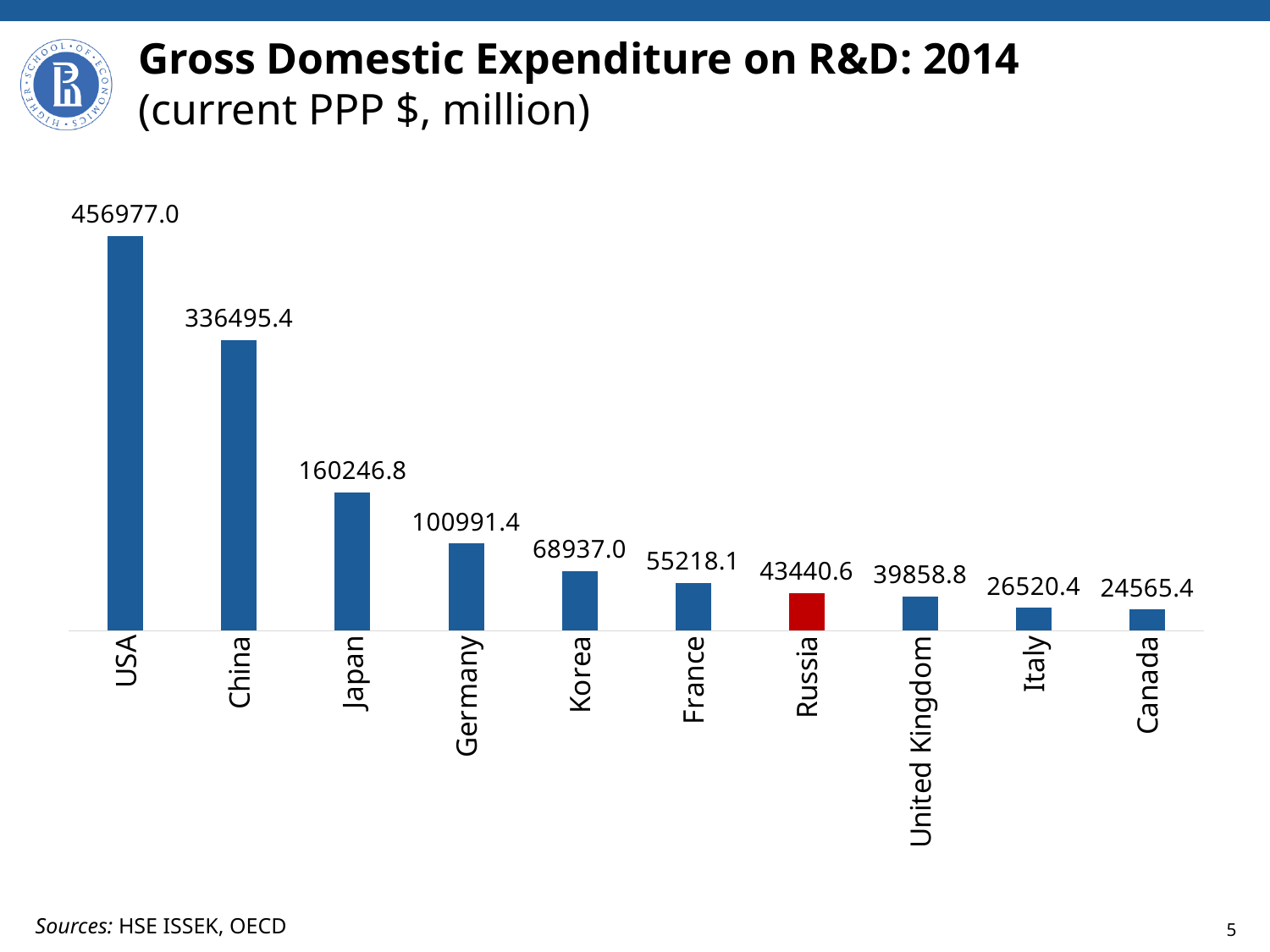
What is the gross domestic expenditure on R&D for Russia? 43440.6 Do the values rise or fall from left to right across the chart? Fall Which country has the lowest value on the chart? Canada Which has a larger value, Korea or France? Korea What value is shown for Germany? 100991.4 What kind of chart is shown on the slide? Bar chart How many countries are shown on the chart? 10 What is the value for the United Kingdom? 39858.8 Which country's bar is coloured red? Russia Which country has the highest gross domestic expenditure on R&D? USA What is the difference between the values for USA and China? 120481.6 What is the difference between the values for Japan and Germany? 59255.4